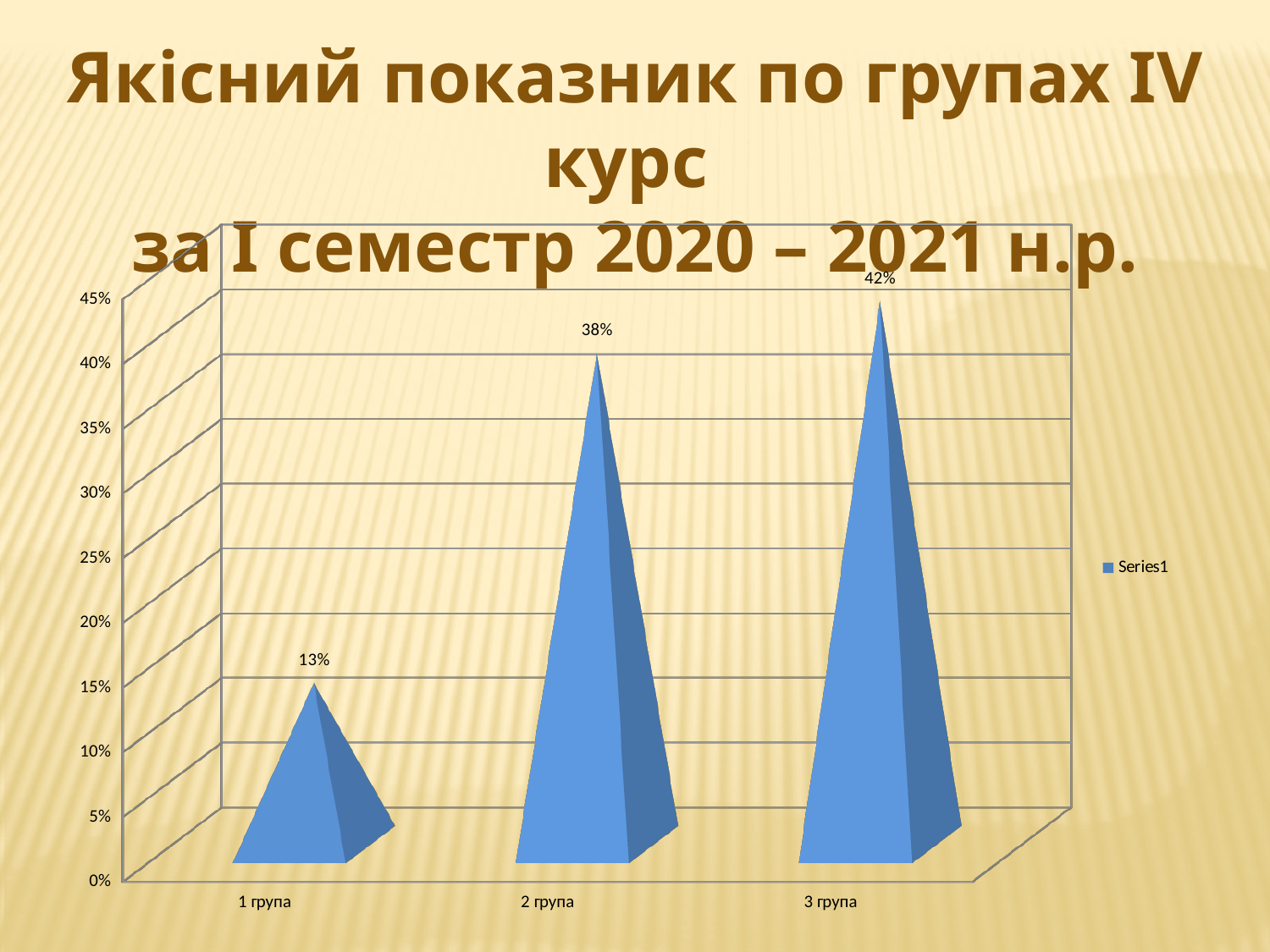
What is the value for 1 група? 13% What is the value for 3 група? 42% Do the values rise or fall from 1 група to 3 група? rise What is the value for 2 група? 38% What is the difference between the values for 2 група and 1 група? 25% How many series does the legend list? 1 Which group has the lowest value? 1 група Which group has the highest value? 3 група How many groups are shown on the x axis? 3 Is the value for 2 група greater or less than 30%? greater What is the difference between the values for 3 група and 1 група? 29% Which is larger, the value for 2 група or the value for 1 група? 2 група